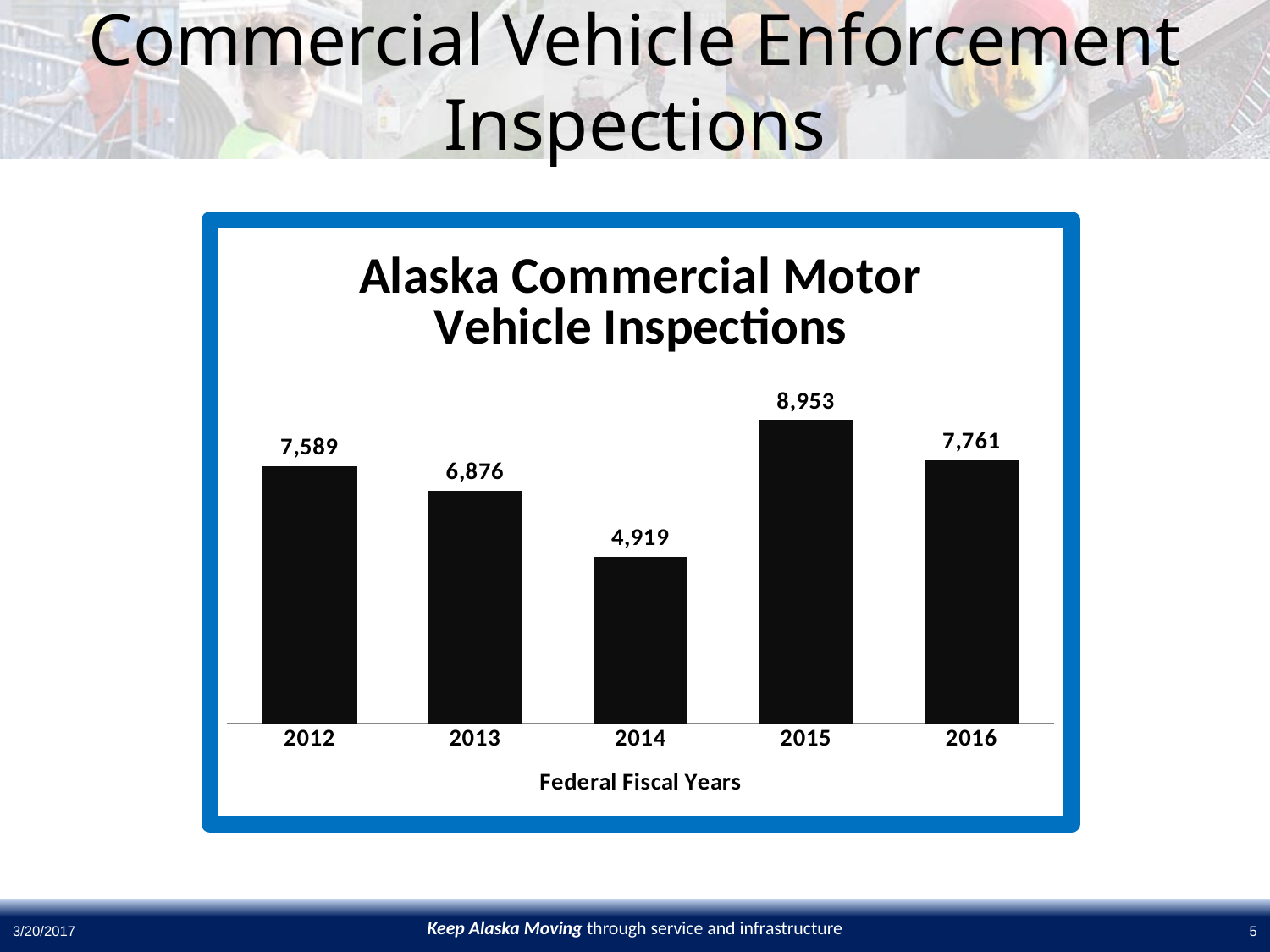
What is the number of inspections for 2014? 4,919 What is the difference in inspections between 2016 and 2013? 885 What is the difference in inspections between 2015 and 2014? 4,034 Did the number of inspections rise or fall from 2013 to 2014? Fall What kind of chart is shown? Bar chart Which year has the lowest number of inspections? 2014 What is the number of inspections for 2012? 7,589 Which year had more inspections, 2012 or 2016? 2016 What is the title of the chart? Alaska Commercial Motor Vehicle Inspections How many years are shown on the chart? 5 What is the number of inspections for 2015? 8,953 Which year has the highest number of inspections? 2015